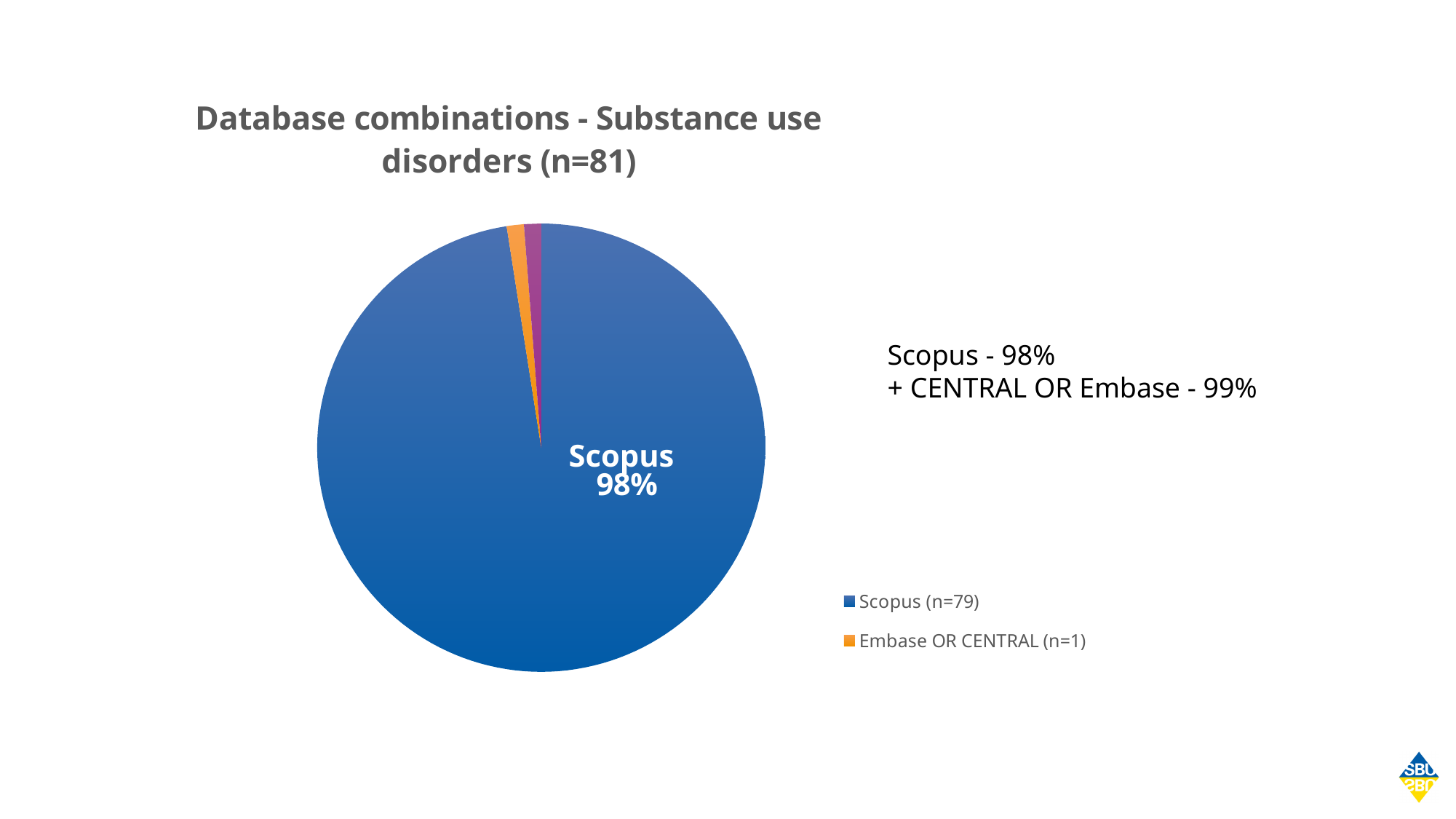
What colour is the Scopus slice in the pie chart? blue How many entries does the legend list? 2 What kind of chart is shown on the slide? pie chart Is the share of the Scopus slice greater or less than 50%? greater What is the total n given in the chart title? 81 Which is larger, the Scopus slice or the Embase OR CENTRAL slice? Scopus What is the n value shown in the legend for Embase OR CENTRAL? 1 What share of the pie does the Scopus slice represent? 98% What is the difference in n between Scopus (n=79) and Embase OR CENTRAL (n=1)? 78 What is the n value shown in the legend for Scopus? 79 Which category has the largest slice of the pie? Scopus What is the title of the chart? Database combinations - Substance use disorders (n=81)